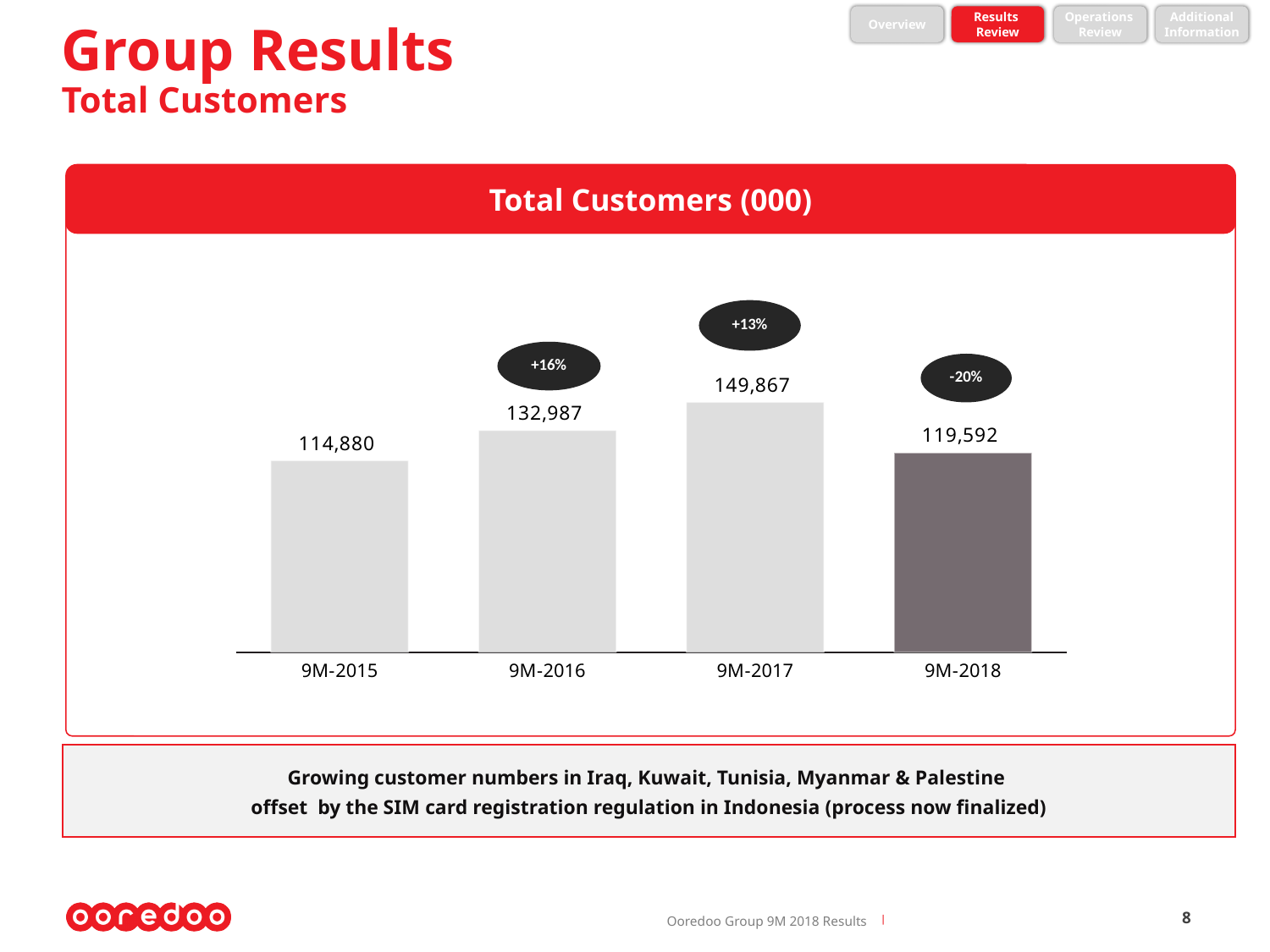
What is the difference between the 9M-2017 and 9M-2018 values? 30,275 What is the value for 9M-2018 in the Total Customers (000) chart? 119,592 Which is larger, the value for 9M-2016 or the value for 9M-2018? 9M-2016 Which period has the lowest total customers? 9M-2015 Which period has the highest total customers? 9M-2017 What percentage change is shown above the 9M-2018 bar? -20% What is the difference between the 9M-2016 and 9M-2015 values? 18,107 What is the value for 9M-2017 in the Total Customers (000) chart? 149,867 What is the title of the chart? Total Customers (000) What is the value for 9M-2015 in the Total Customers (000) chart? 114,880 How many periods are shown in the chart? 4 What kind of chart is shown on the slide? Bar chart